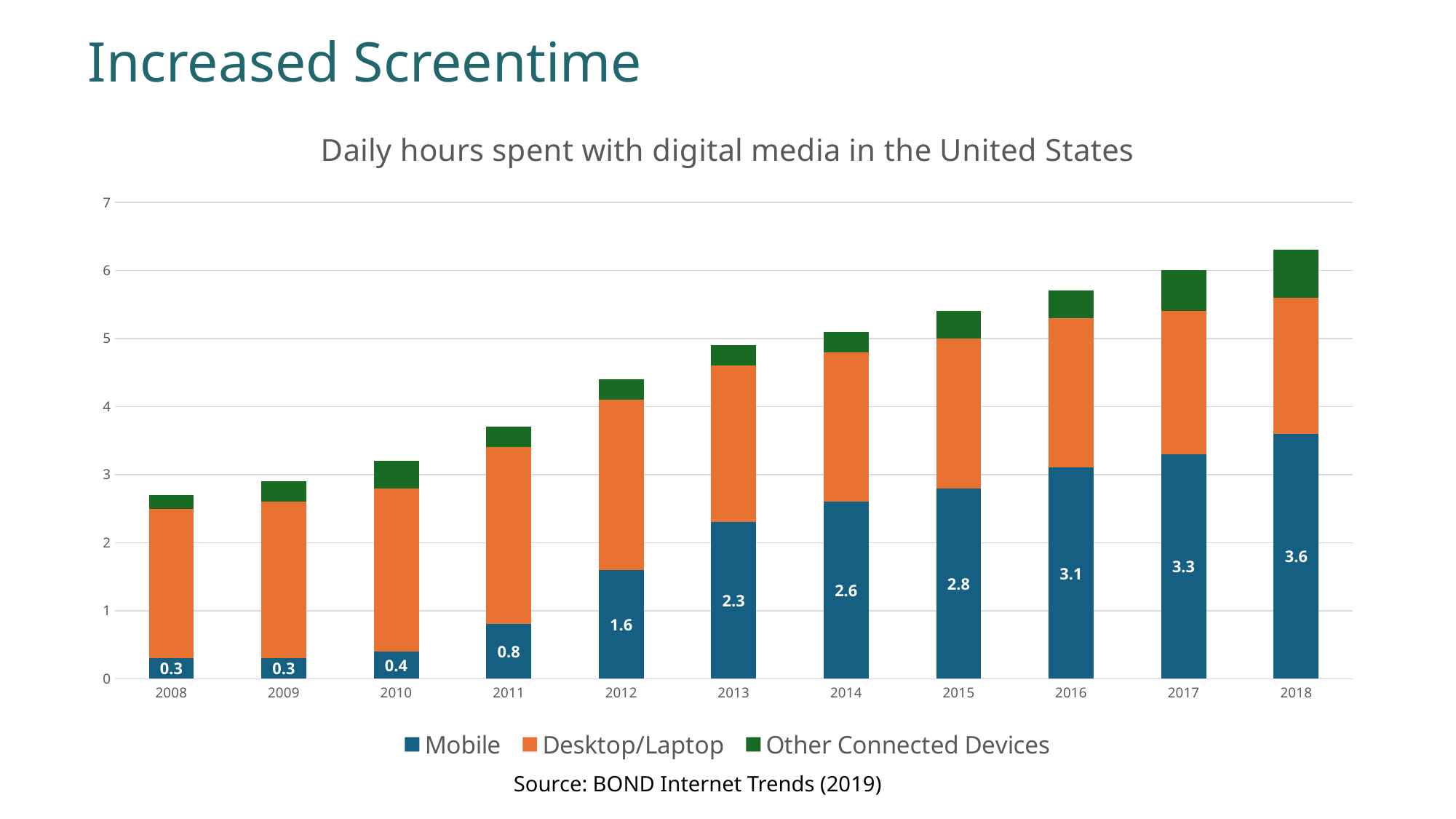
How many years are shown on the x axis? 11 Is the total height of the 2018 bar greater or less than 6? greater What is the difference between the Mobile values for 2018 and 2008? 3.3 What is the Mobile value for 2018? 3.6 Do the Mobile values rise or fall from 2008 to 2018? Rise Which is larger, the Mobile value for 2015 or for 2014? 2015 How many series does the legend list? 3 What is the Mobile value for 2012? 1.6 What is the Mobile value for 2010? 0.4 Is the total height of the 2008 bar greater or less than 3? less Which year has the highest Mobile value? 2018 What kind of chart is shown on the slide? Stacked bar chart